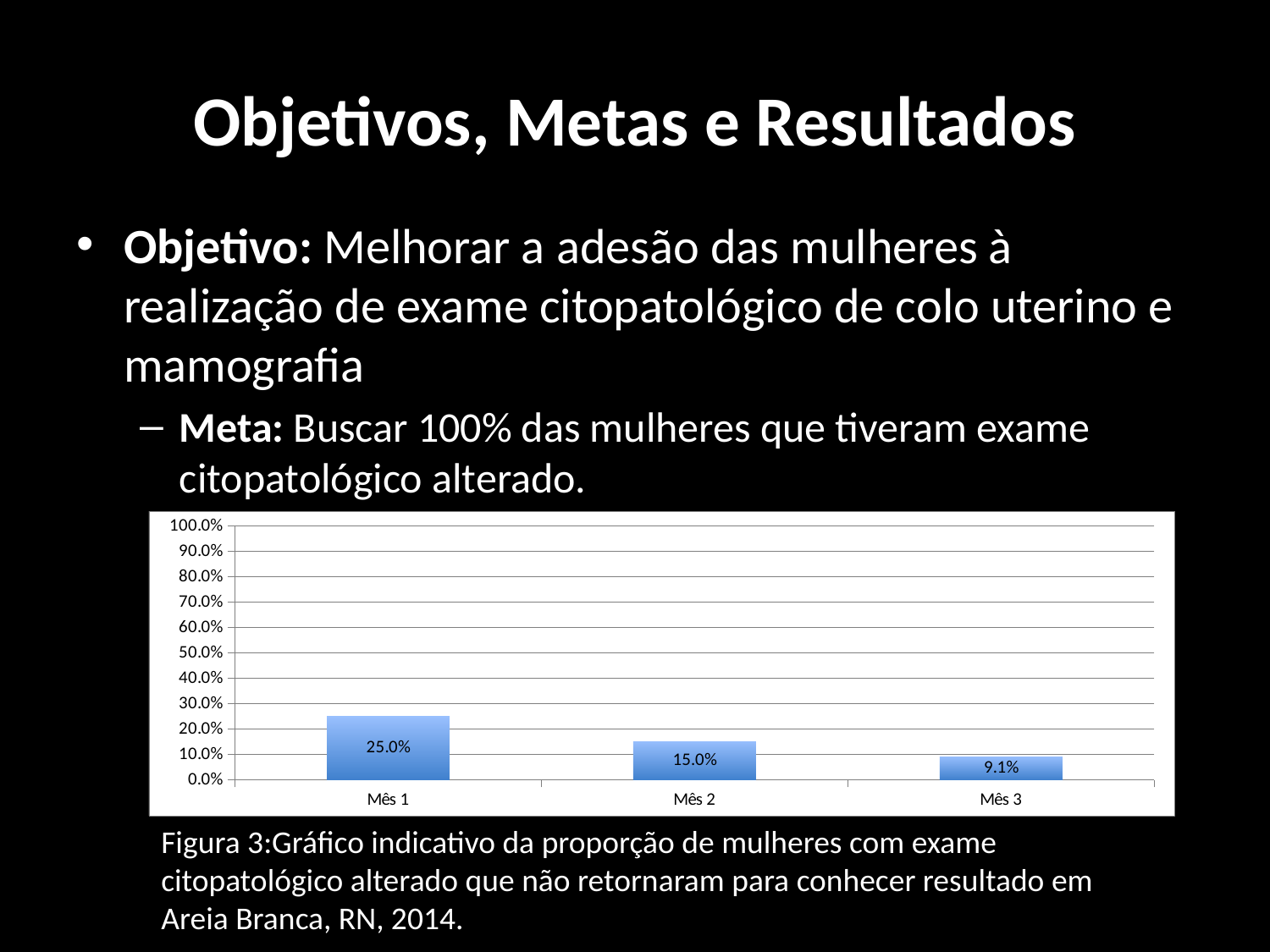
How many categories are shown on the x axis? 3 Is the value for Mês 1 greater or less than 20.0%? greater What is the value for Mês 3? 9.1% What is the difference between the values for Mês 2 and Mês 3? 5.9% Which month has the highest value? Mês 1 Which is larger, the value for Mês 1 or the value for Mês 3? Mês 1 Which month has the lowest value? Mês 3 What is the value for Mês 1? 25.0% What is the value for Mês 2? 15.0% What kind of chart is shown on the slide? Bar chart What is the difference between the values for Mês 1 and Mês 2? 10.0% Do the values rise or fall from Mês 1 to Mês 3? Fall